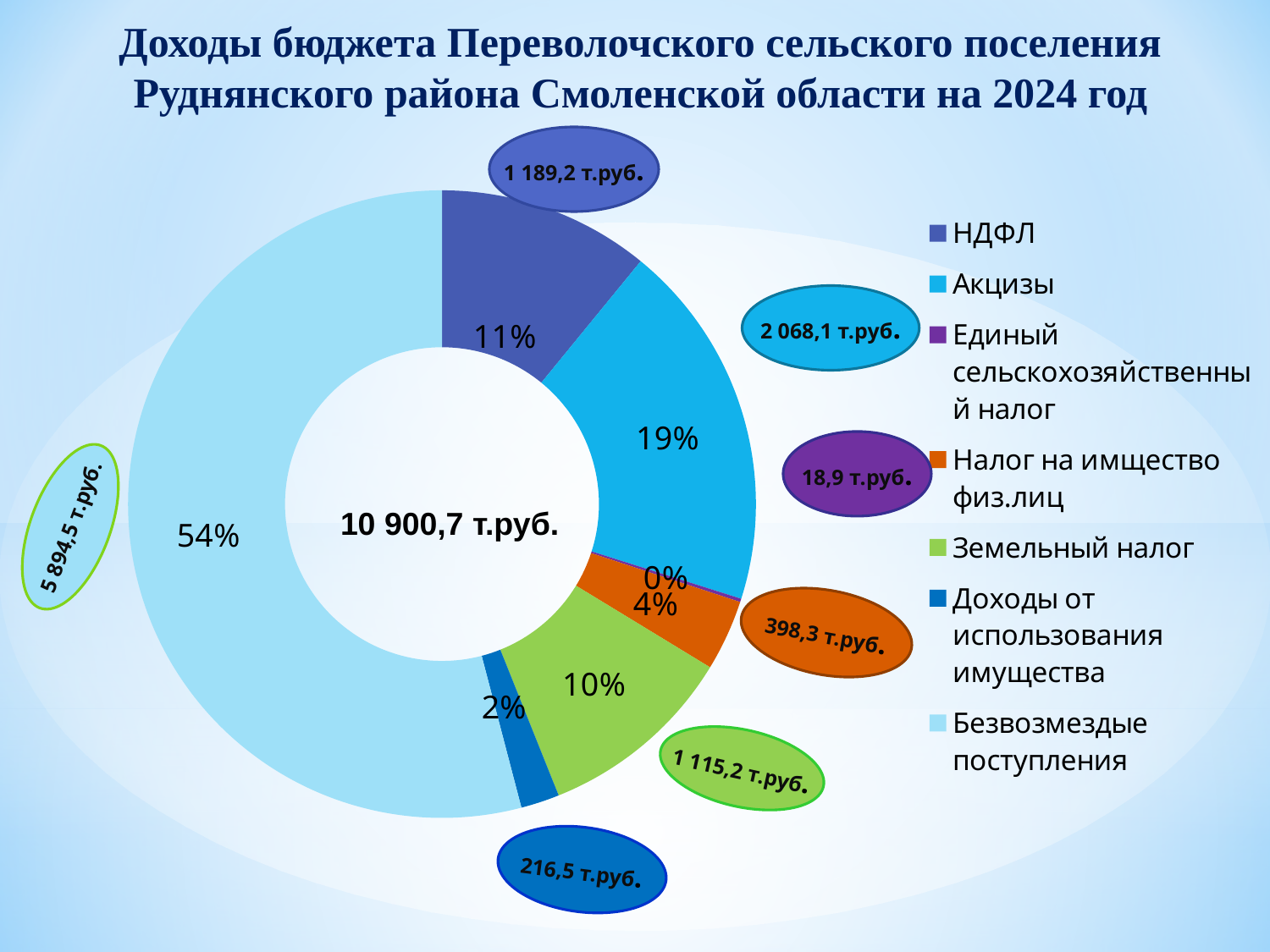
Which category has the largest share of the pie? Безвозмездные поступления What share of the pie does Безвозмездные поступления hold? 54% What share of the pie does Акцизы hold? 19% What is the value shown for Акцизы in the callout? 2 068,1 т.руб. What is the value shown for Единый сельскохозяйственный налог in the callout? 18,9 т.руб. What is the value shown for Безвозмездные поступления in the callout? 5 894,5 т.руб. What total value is printed in the centre of the chart? 10 900,7 т.руб. Which is larger, the share for Акцизы or the share for НДФЛ? Акцизы What share of the pie does Земельный налог hold? 10% How many categories does the legend list? 7 Which category has the smallest share of the pie? Единый сельскохозяйственный налог